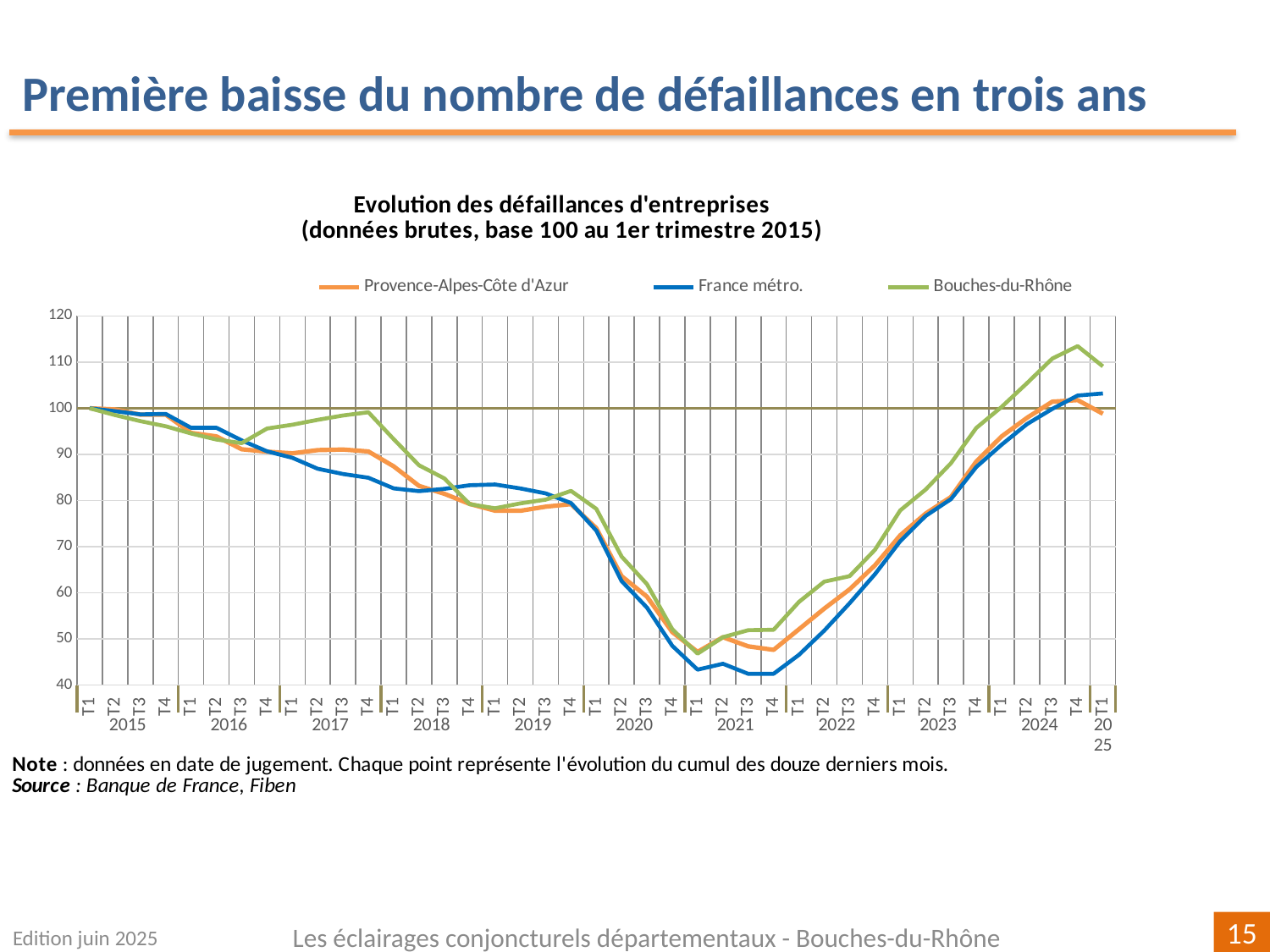
At T4 2024, which is larger: Bouches-du-Rhône or France métro.? Bouches-du-Rhône How many series does the legend list? 3 Is the value for Bouches-du-Rhône at T4 2017 greater or less than 90? greater What is the title of the chart? Evolution des défaillances d'entreprises (données brutes, base 100 au 1er trimestre 2015) Is the value for Bouches-du-Rhône at T4 2024 greater or less than 110? greater Which series has the lowest value at T4 2021? France métro. Is the value for France métro. at T1 2021 greater or less than 50? less What is the value of the France métro. series at T1 2015? 100 Does the France métro. series rise or fall between T1 2015 and T1 2021? fall Which series has the highest value at T1 2025? Bouches-du-Rhône Which three series are listed in the legend? Provence-Alpes-Côte d'Azur, France métro., Bouches-du-Rhône What kind of chart is shown on the slide? line chart